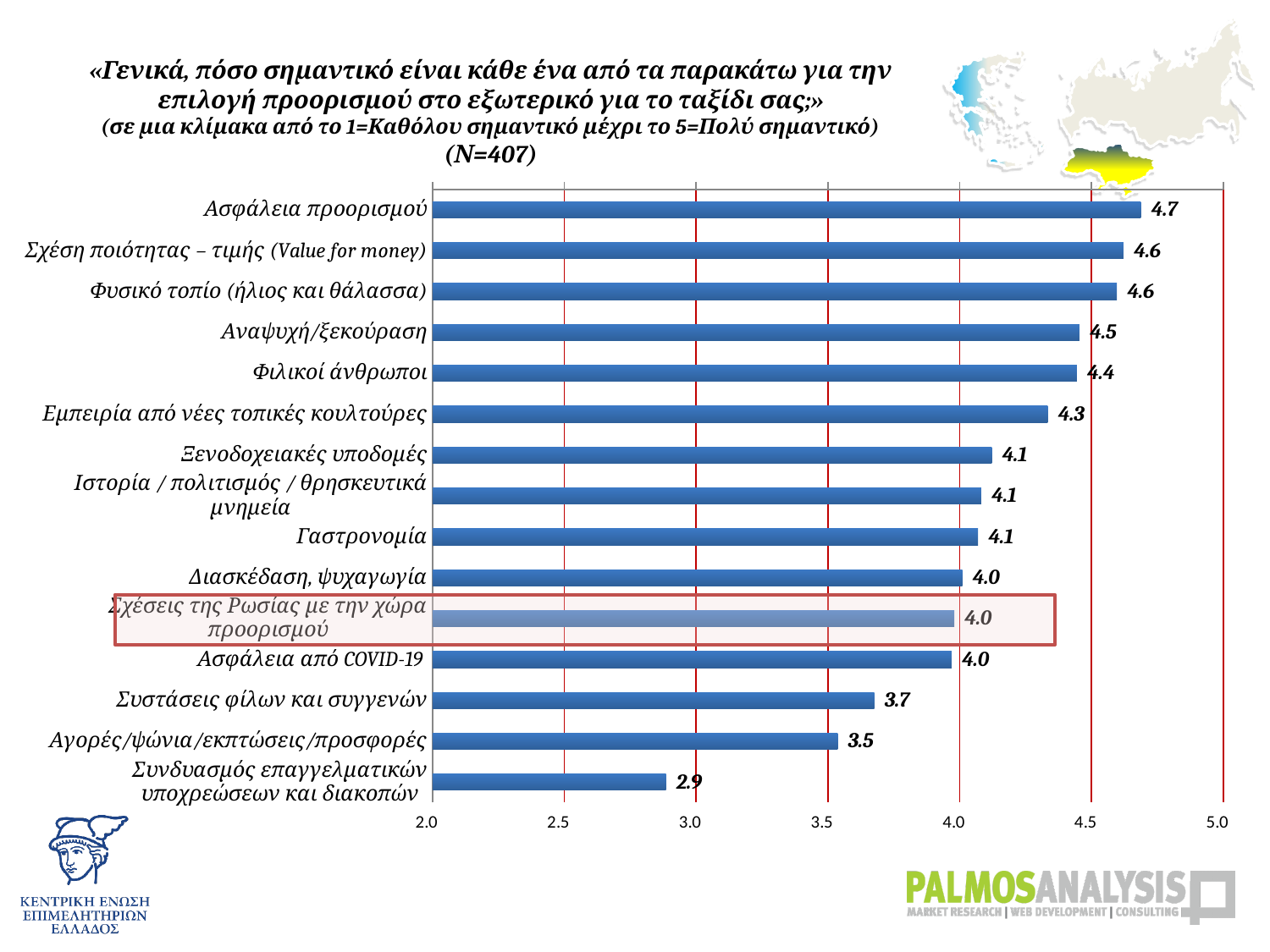
What kind of chart is shown on the slide? bar chart What is the sample size (N) stated in the chart title? 407 What is the value for Συστάσεις φίλων και συγγενών? 3.7 What is the value for Σχέσεις της Ρωσίας με την χώρα προορισμού? 4.0 Which is larger, the value for Φιλικοί άνθρωποι or the value for Γαστρονομία? Φιλικοί άνθρωποι How many categories are shown in the chart? 15 Which category has the lowest value? Συνδυασμός επαγγελματικών υποχρεώσεων και διακοπών Is the value for Εμπειρία από νέες τοπικές κουλτούρες greater or less than 4.0? greater What is the value for Ασφάλεια προορισμού? 4.7 What is the difference between the values for Ασφάλεια προορισμού and Συνδυασμός επαγγελματικών υποχρεώσεων και διακοπών? 1.8 What is the value for Αγορές/ψώνια/εκπτώσεις/προσφορές? 3.5 Which category has the highest value? Ασφάλεια προορισμού